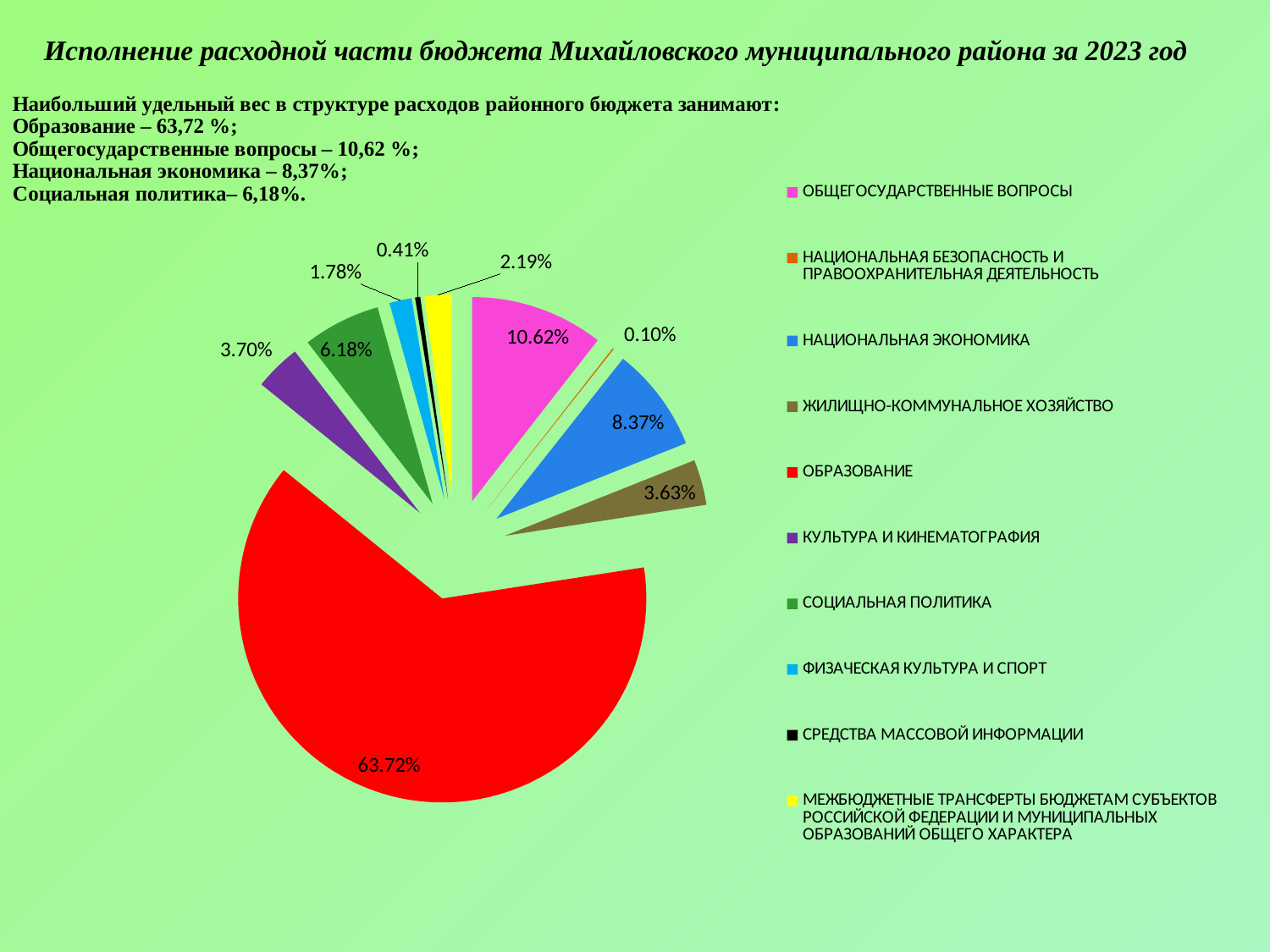
What is the value shown for НАЦИОНАЛЬНАЯ ЭКОНОМИКА? 8.37% What is the difference between the values for ОБЩЕГОСУДАРСТВЕННЫЕ ВОПРОСЫ and НАЦИОНАЛЬНАЯ ЭКОНОМИКА? 2.25% What kind of chart is shown on the slide? pie chart What colour is the slice for ОБРАЗОВАНИЕ? red What is the value shown for ЖИЛИЩНО-КОММУНАЛЬНОЕ ХОЗЯЙСТВО? 3.63% What is the value shown for СРЕДСТВА МАССОВОЙ ИНФОРМАЦИИ? 0.41% What share of the pie does ОБРАЗОВАНИЕ have? 63.72% How many slices does the pie chart have? 10 What is the value shown for ОБЩЕГОСУДАРСТВЕННЫЕ ВОПРОСЫ? 10.62% Which is larger, the slice for СОЦИАЛЬНАЯ ПОЛИТИКА or the slice for КУЛЬТУРА И КИНЕМАТОГРАФИЯ? СОЦИАЛЬНАЯ ПОЛИТИКА Which category has the smallest slice of the pie? НАЦИОНАЛЬНАЯ БЕЗОПАСНОСТЬ И ПРАВООХРАНИТЕЛЬНАЯ ДЕЯТЕЛЬНОСТЬ Which category has the largest slice of the pie? ОБРАЗОВАНИЕ